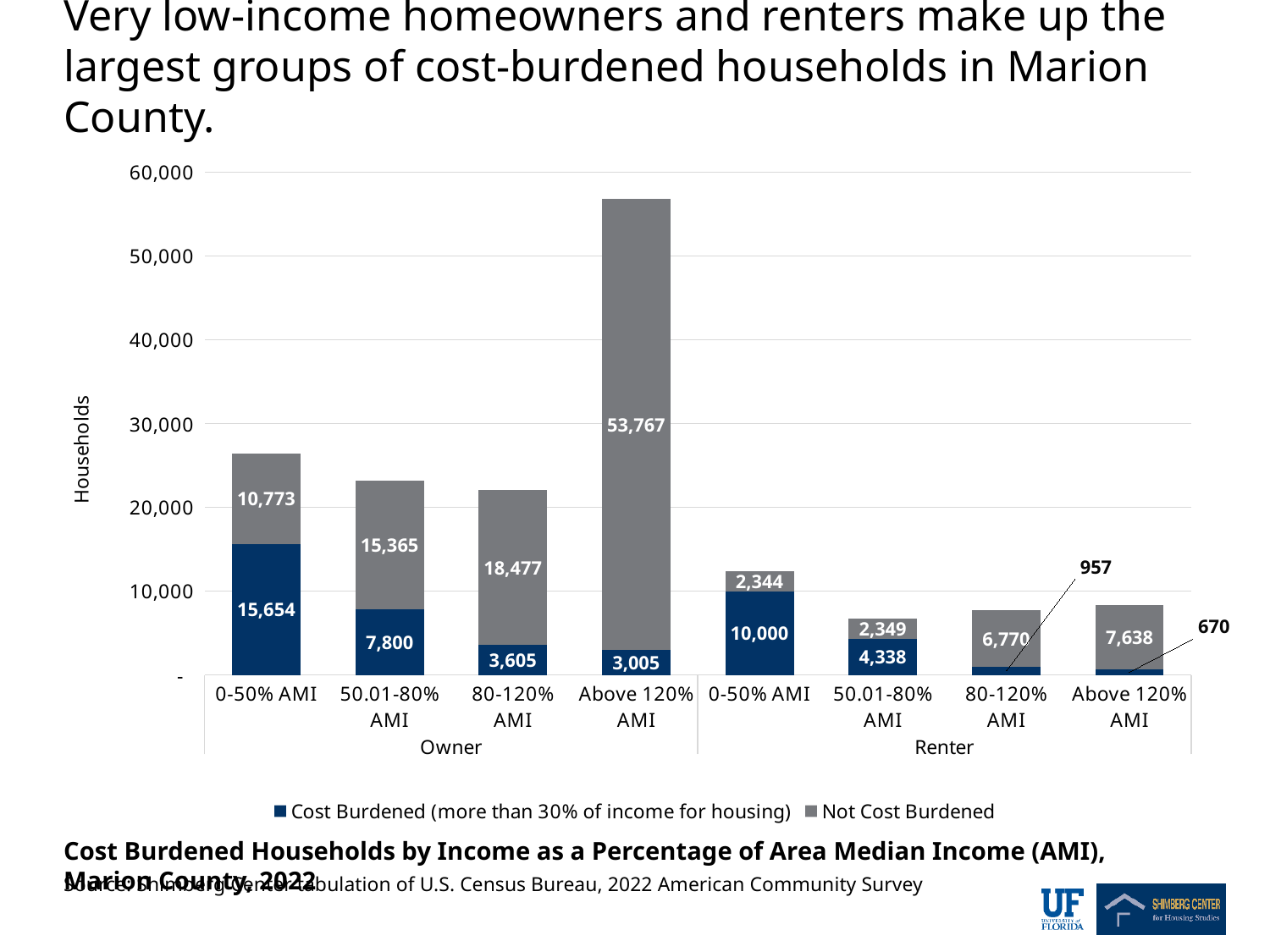
Which category has the smallest number of cost-burdened households? Renter Above 120% AMI How many not-cost-burdened renter households are in the 50.01-80% AMI category? 2,349 Which is larger: the number of cost-burdened owner households at 80-120% AMI or cost-burdened renter households at 50.01-80% AMI? Cost-burdened renter households at 50.01-80% AMI What is the total number of owner households in the 50.01-80% AMI category (cost burdened plus not cost burdened)? 23,165 How many cost-burdened renter households are in the 80-120% AMI category? 957 How many not-cost-burdened owner households are in the Above 120% AMI category? 53,767 How many cost-burdened owner households are in the 0-50% AMI category? 15,654 Is the total height of the Owner Above 120% AMI bar greater or less than 50,000? greater How many series does the legend list? 2 Which category has the largest number of cost-burdened households? Owner 0-50% AMI What type of chart is shown on the slide? Stacked bar chart What is the difference between cost-burdened owner households at 0-50% AMI and cost-burdened renter households at 0-50% AMI? 5,654